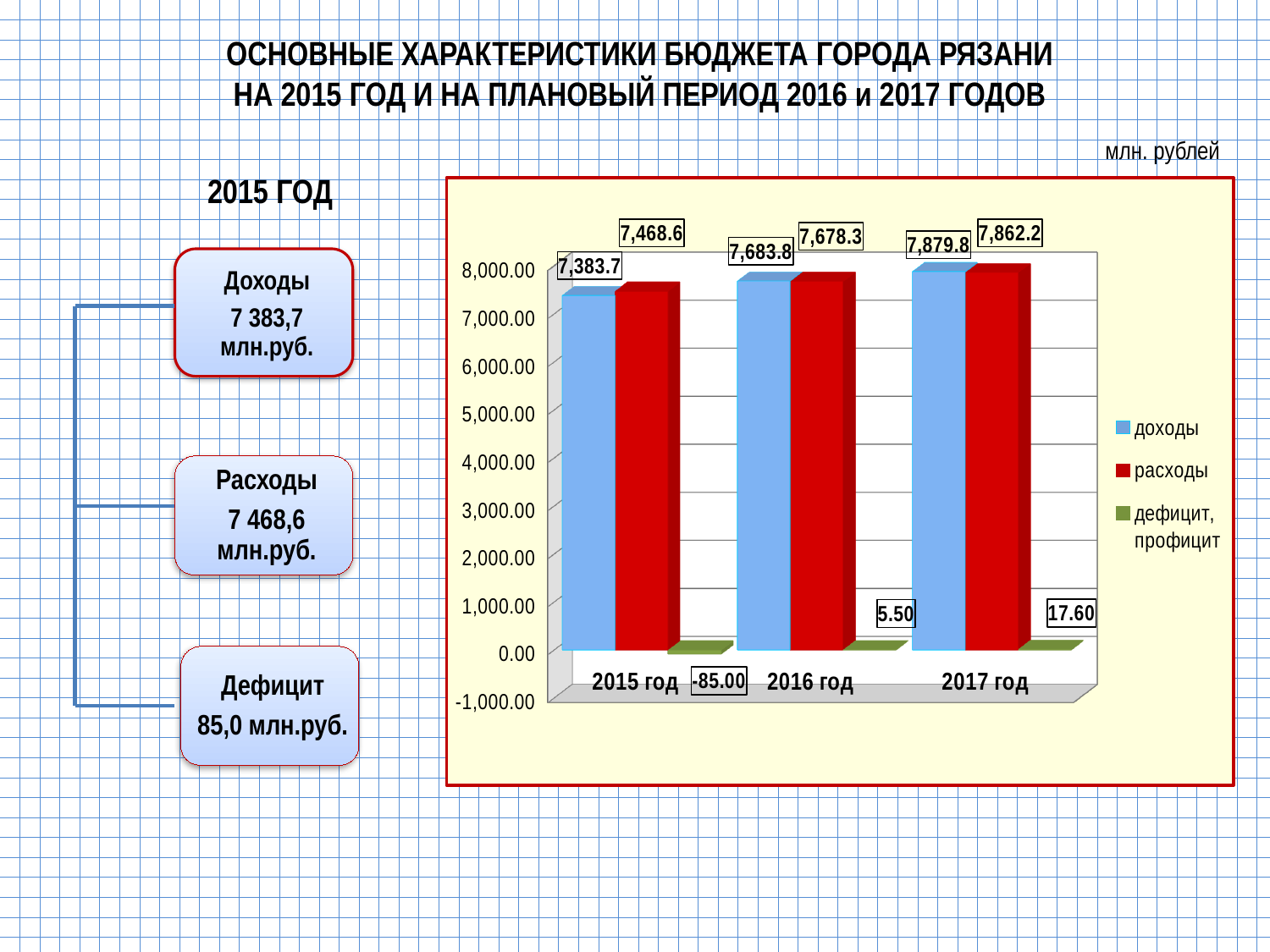
How many series does the legend list? 3 Which is larger for 2017 год: доходы or расходы? доходы What kind of chart is shown on the slide? bar chart What is the value of дефицит, профицит for 2015 год? -85.00 Which year has the lowest value of расходы? 2015 год Do the values of доходы rise or fall from 2015 год to 2017 год? rise What is the value of доходы for 2015 год? 7,383.7 Which year has the highest value of доходы? 2017 год What is the difference between расходы and доходы for 2015 год? 84.9 What is the value of расходы for 2017 год? 7,862.2 What is the difference between доходы for 2017 год and доходы for 2016 год? 196.0 What is the value of дефицит, профицит for 2016 год? 5.50